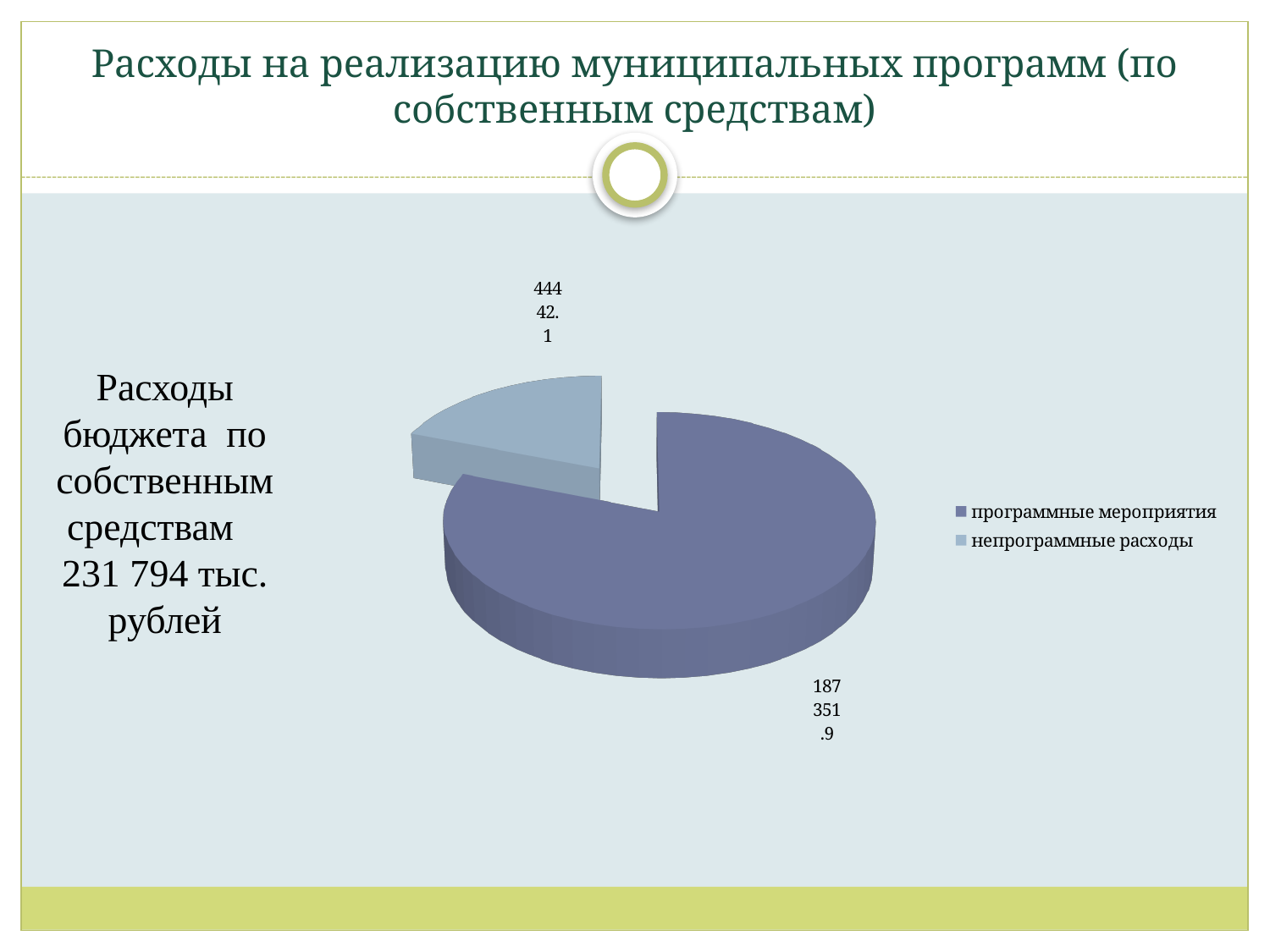
Which legend entry is shown in the lighter blue colour? непрограммные расходы Which category has the largest slice in the pie chart? программные мероприятия What kind of chart is shown on the slide? pie chart Which category has the smallest slice in the pie chart? непрограммные расходы What share of the pie does программные мероприятия represent, to one decimal place? 80.8% How many slices does the pie chart have? 2 What is the value for непрограммные расходы in the pie chart? 44442.1 Which is larger: программные мероприятия or непрограммные расходы? программные мероприятия How many entries does the legend list? 2 What is the total of the two slices in the pie chart? 231794 What is the value for программные мероприятия in the pie chart? 187351.9 What is the difference between the values for программные мероприятия and непрограммные расходы? 142909.8